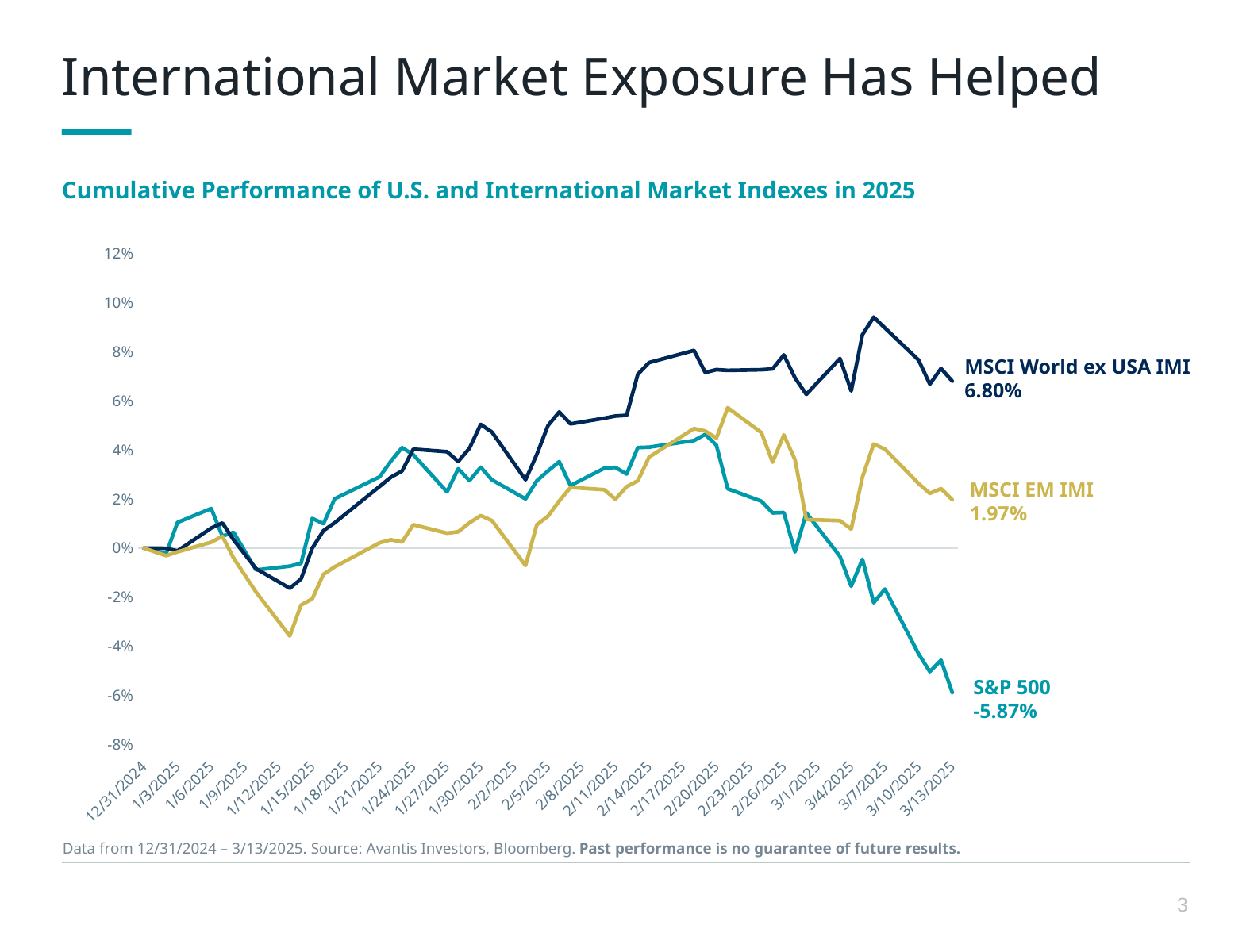
What is the difference in percentage points between the labeled end values of MSCI World ex USA IMI and the S&P 500? 12.67 percentage points Which index has the highest cumulative performance at the end of the chart? MSCI World ex USA IMI What is the difference in percentage points between the labeled end values of MSCI World ex USA IMI and MSCI EM IMI? 4.83 percentage points At the end of the chart, which has the larger cumulative performance: MSCI EM IMI or the S&P 500? MSCI EM IMI Does the S&P 500 line rise or fall between 2/20/2025 and 3/13/2025? Fall What is the cumulative performance value labeled for MSCI World ex USA IMI at the end of the chart? 6.80% How many index series are plotted on the chart? 3 Which index has the lowest cumulative performance at the end of the chart? S&P 500 What is the cumulative performance value labeled for MSCI EM IMI at the end of the chart? 1.97% What is the cumulative performance value labeled for the S&P 500 at the end of the chart? -5.87% Is the peak value of the MSCI World ex USA IMI line around 3/7/2025 greater or less than 8%? greater What type of chart is shown on the slide? Line chart